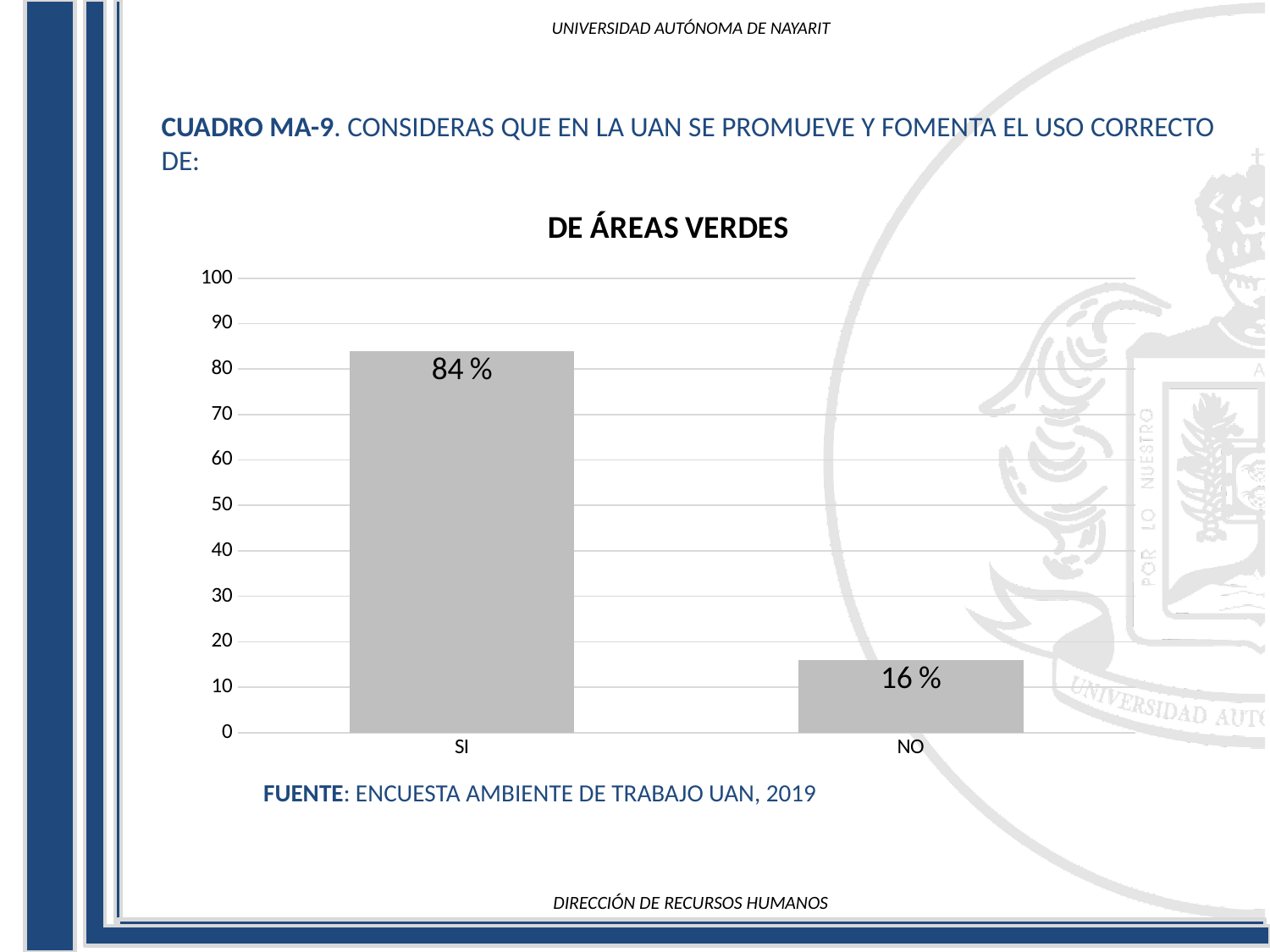
Which is larger, the value for SI or the value for NO? SI What is the difference between the values for SI and NO? 68 % Is the value for NO greater or less than 20? less What is the value for SI? 84 % Which category has the highest value? SI What is the maximum value shown on the y axis? 100 Which category has the lowest value? NO How many categories are shown on the x axis? 2 Is the value for SI greater or less than 80? greater What is the title of the chart? DE ÁREAS VERDES What kind of chart is shown? bar chart What is the value for NO? 16 %